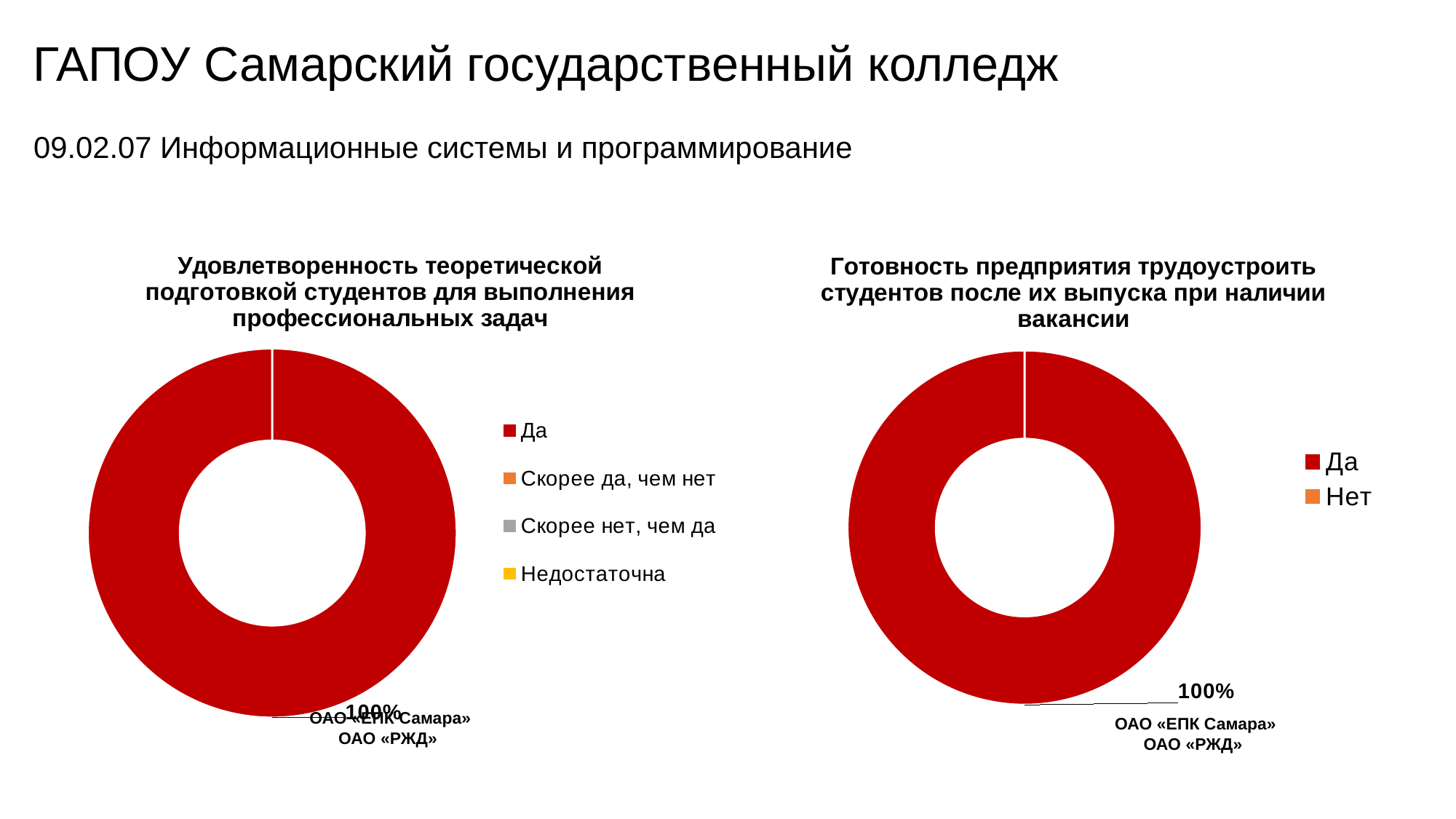
In the right chart ("Готовность предприятия трудоустроить..."), what share of the ring does the "Да" category take? 100% How many entries does the legend of the left chart ("Удовлетворенность теоретической подготовкой...") list? 4 In the left chart ("Удовлетворенность теоретической подготовкой..."), which category has the largest share? Да In the right chart ("Готовность предприятия трудоустроить..."), which category has the largest share? Да In the left chart ("Удовлетворенность теоретической подготовкой..."), what is the data label printed on the ring? 100% What kind of chart is the left chart, titled "Удовлетворенность теоретической подготовкой студентов для выполнения профессиональных задач"? Doughnut (pie) chart Which legend entry in the left chart ("Удовлетворенность теоретической подготовкой...") is shown in yellow? Недостаточна How many entries does the legend of the right chart ("Готовность предприятия трудоустроить...") list? 2 In the right chart ("Готовность предприятия трудоустроить..."), which is larger, the share for "Да" or the share for "Нет"? Да In the left chart ("Удовлетворенность теоретической подготовкой..."), what share of the ring does the "Да" category take? 100% What colour represents the "Да" category in the right chart ("Готовность предприятия трудоустроить...")? Red What kind of chart is the right chart, titled "Готовность предприятия трудоустроить студентов после их выпуска при наличии вакансии"? Doughnut (pie) chart